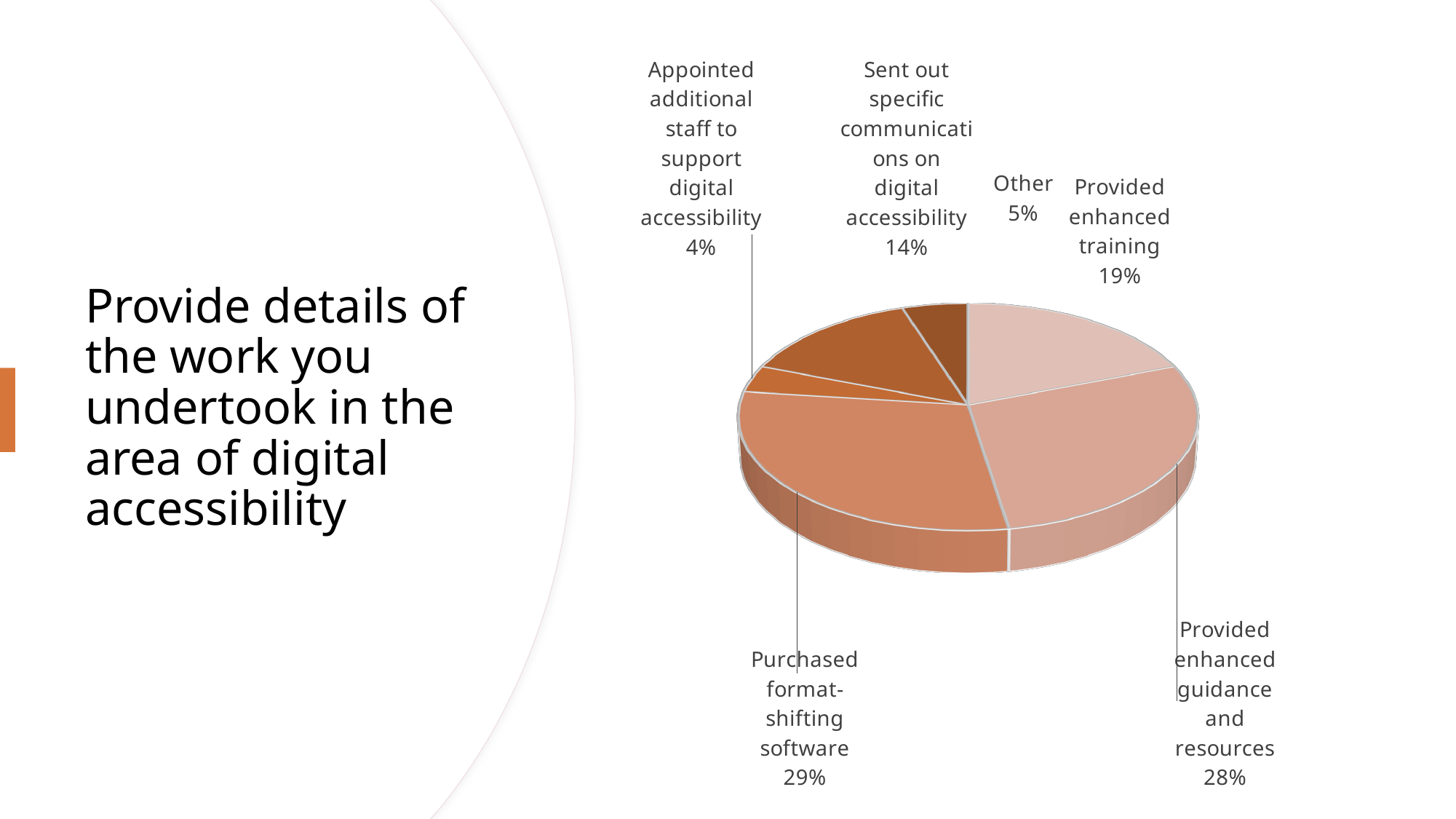
What is the title text shown on the left of the slide? Provide details of the work you undertook in the area of digital accessibility What share of the pie is 'Purchased format-shifting software'? 29% What kind of chart is shown on the slide? Pie chart Which category has the smallest share of the pie? Appointed additional staff to support digital accessibility Which category has the largest share of the pie? Purchased format-shifting software What share of the pie is 'Sent out specific communications on digital accessibility'? 14% What share of the pie is 'Provided enhanced guidance and resources'? 28% What is the difference in percentage points between 'Provided enhanced training' and 'Sent out specific communications on digital accessibility'? 5 Which is larger: the share for 'Other' or the share for 'Appointed additional staff to support digital accessibility'? Other How many slices does the pie chart have? 6